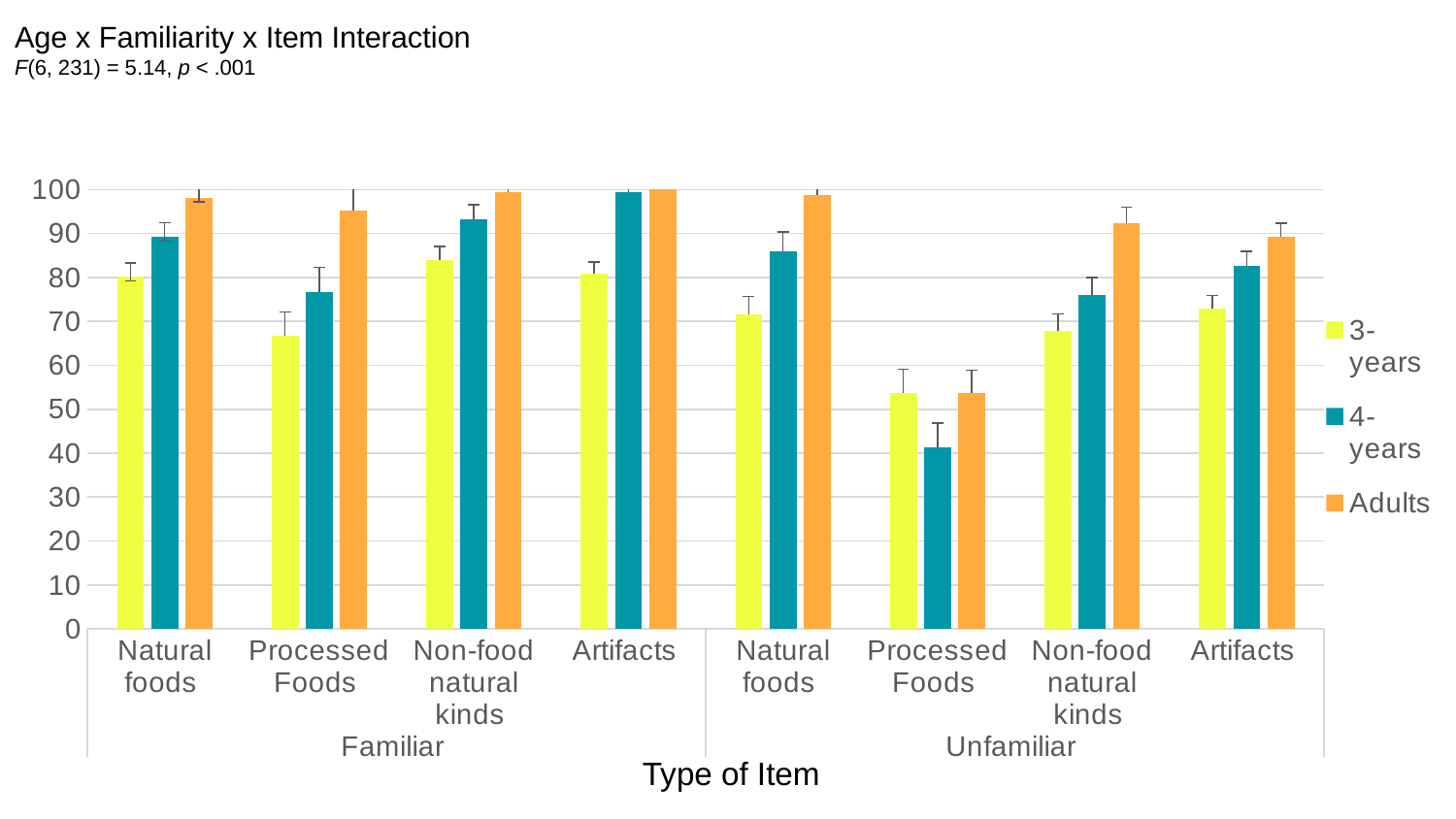
Which is larger for 4-years: Familiar Artifacts or Familiar Processed Foods? Familiar Artifacts How many series does the legend list? 3 Is the 4-years value for Unfamiliar Processed Foods greater or less than 50? less Which bar is the lowest in the whole chart? 4-years, Unfamiliar Processed Foods Which age group has the highest bar for Unfamiliar Non-food natural kinds? Adults What kind of chart is shown on the slide? bar chart Is the Adults value for Familiar Processed Foods greater or less than 90? greater What is the title of the x axis? Type of Item How many item categories are shown along the x axis? 8 Which is larger: the 3-years value for Familiar Natural foods or the 3-years value for Unfamiliar Natural foods? Familiar Natural foods Is the 3-years value for Unfamiliar Natural foods greater or less than 80? less What are the three entries in the legend? 3-years, 4-years, Adults